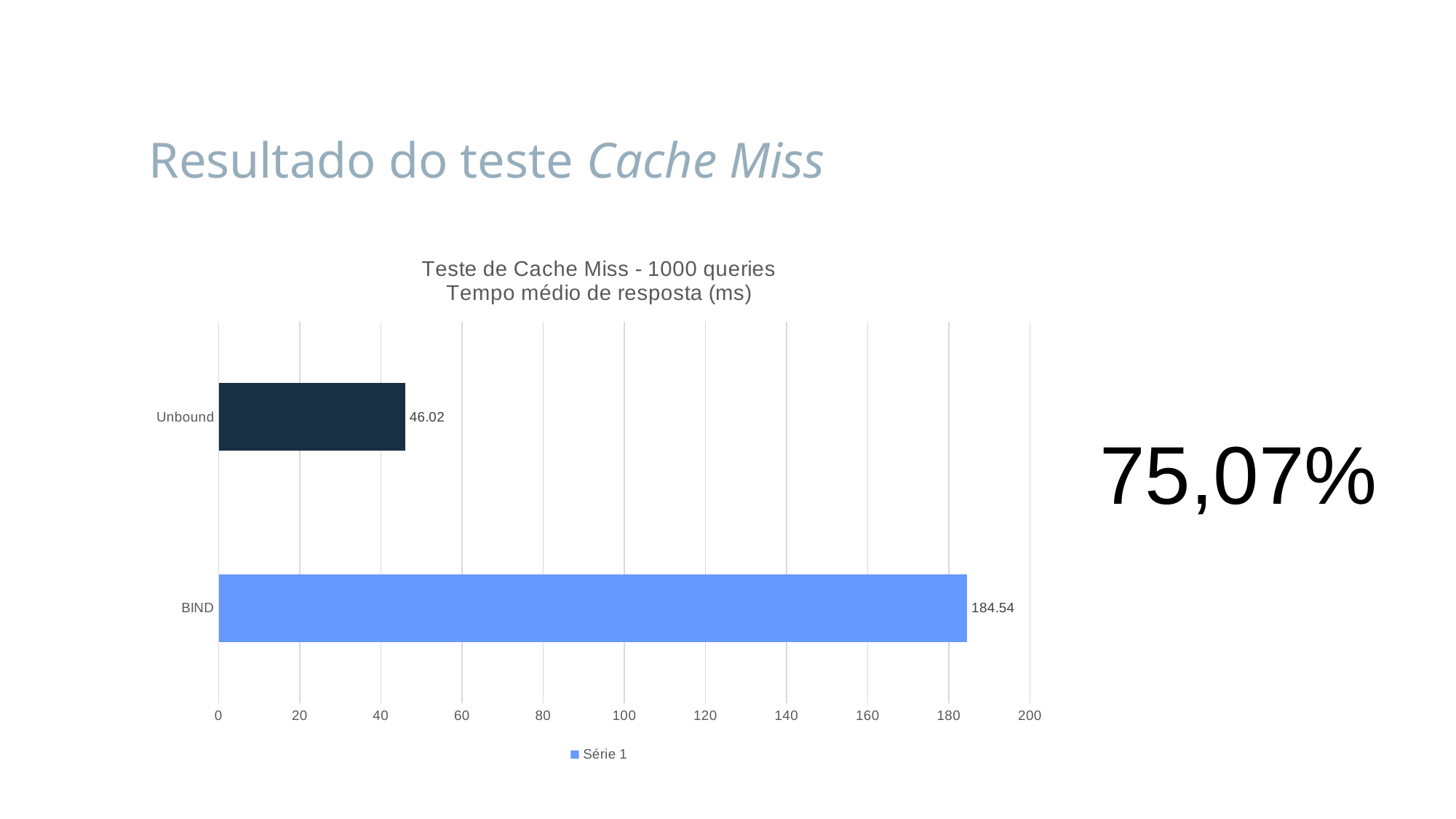
Which category has the highest average response time? BIND Is the value for Unbound greater or less than 60? less Which has a larger value, BIND or Unbound? BIND What is the average response time for Unbound? 46.02 Is the value for BIND greater or less than 160? greater How many series does the legend list? 1 How many categories are shown in the chart? 2 What is the difference between the BIND and Unbound response times? 138.52 What is the name of the series in the legend? Série 1 What is the average response time for BIND? 184.54 Which category has the lowest average response time? Unbound What kind of chart is shown on the slide? Bar chart